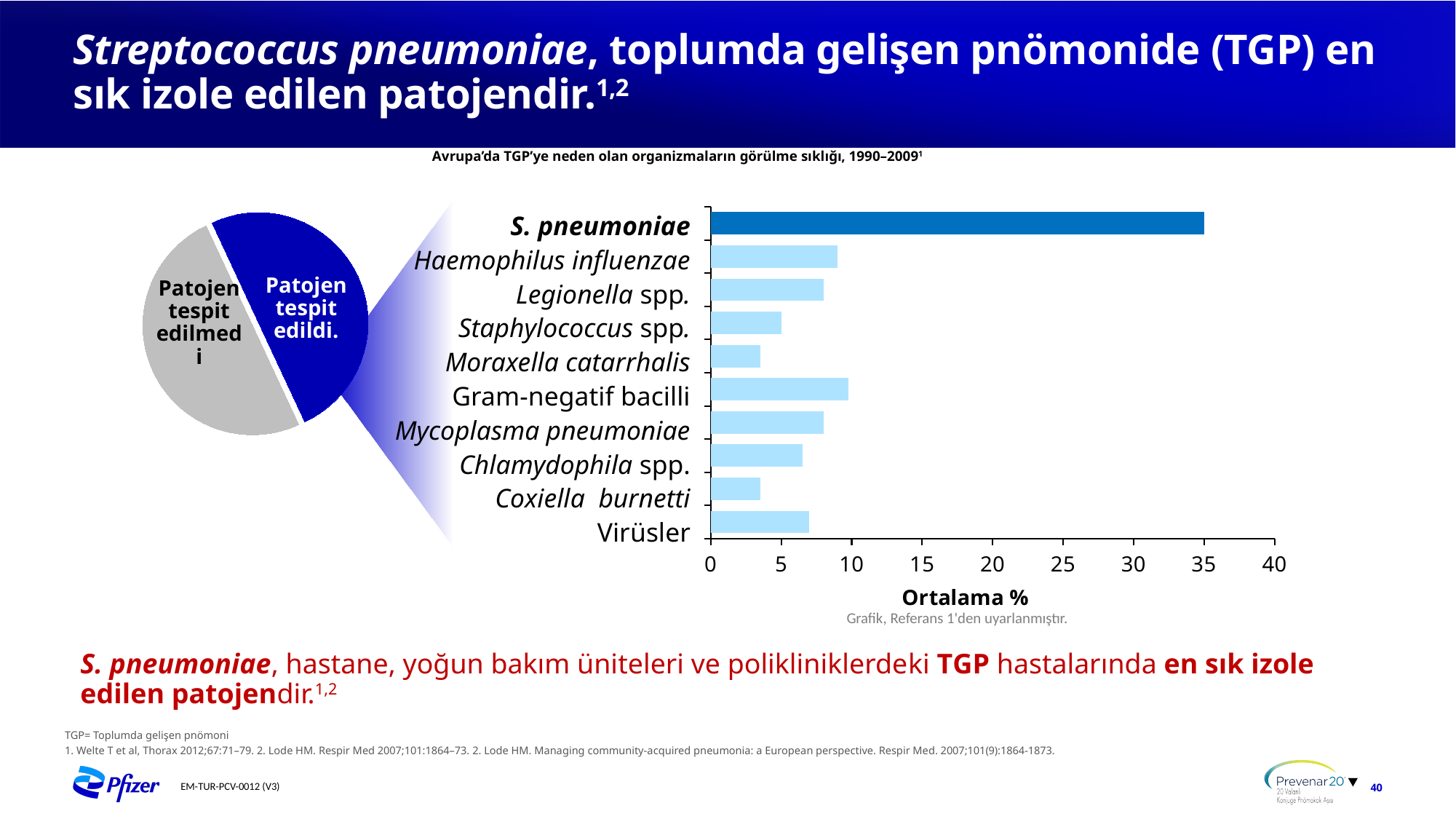
What kind of chart is the chart on the right of the slide? bar chart In the bar chart, is the value for Moraxella catarrhalis greater or less than 5? less What is the label of the horizontal axis of the bar chart? Ortalama % In the bar chart, what is the average percentage for S. pneumoniae? 35 In the bar chart, what is the average percentage for Staphylococcus spp.? 5 In the bar chart, is the value for S. pneumoniae greater or less than 30? greater In the bar chart, which organism has the highest average percentage? S. pneumoniae How many slices does the pie chart on the left have? 2 In the bar chart, which is larger: the value for Virüsler or the value for Moraxella catarrhalis? Virüsler How many organisms are listed as categories in the bar chart? 10 In the bar chart, is the value for Haemophilus influenzae greater or less than 10? less In the bar chart, which is larger: the value for Gram-negatif bacilli or the value for Coxiella burnetti? Gram-negatif bacilli